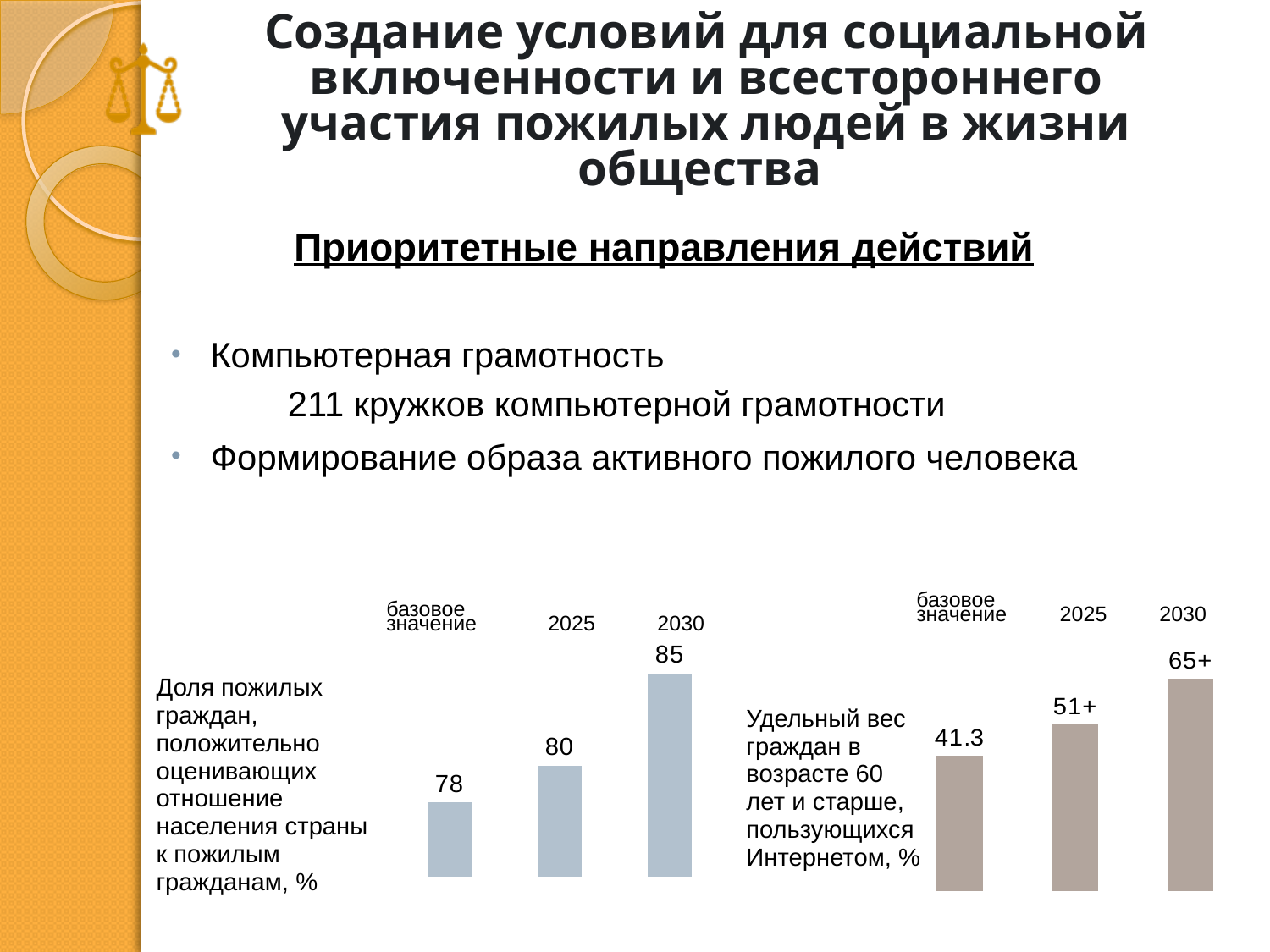
In the left chart, which category has the highest value? 2030 In the right chart, do the values rise or fall from the base value to 2030? rise In the left chart (share of older citizens positively assessing attitudes toward the elderly), what is the base value (базовое значение)? 78 In the right chart (share of citizens aged 60 and older using the Internet), what is the value for 2025? 51+ In the left chart (share of older citizens positively assessing attitudes toward the elderly), what is the value for 2030? 85 In the left chart, which is larger: the value for 2025 or the base value? 2025 How many bars does the left chart have? 3 In the right chart (share of citizens aged 60 and older using the Internet), what is the value for 2030? 65+ In the right chart (share of citizens aged 60 and older using the Internet), what is the base value (базовое значение)? 41.3 In the right chart, which category has the lowest value? базовое значение What kind of chart is the right chart? bar chart In the left chart, what is the difference between the 2030 value and the base value? 7